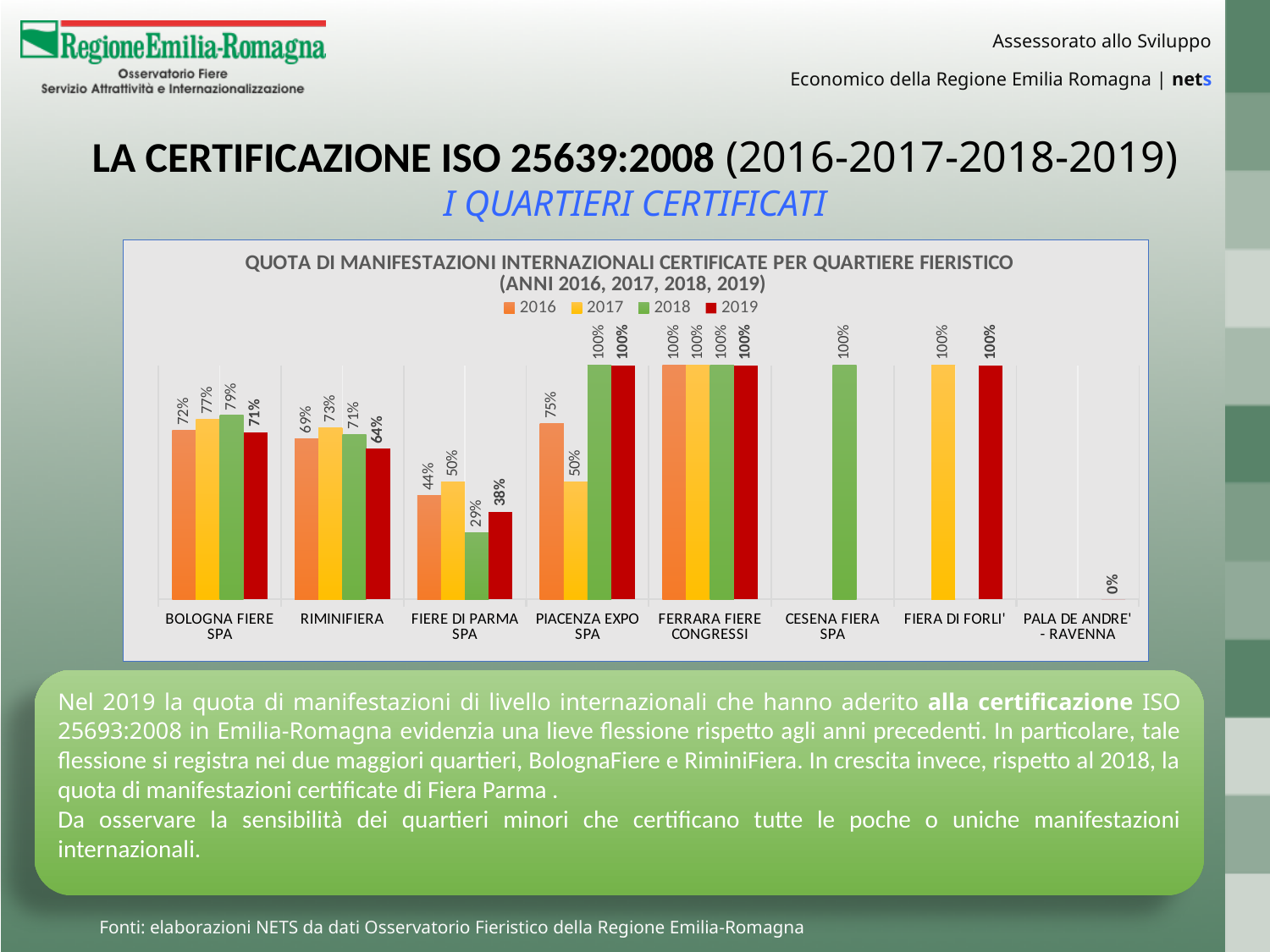
What is the 2017 value for RIMINIFIERA? 73% What is the 2016 value for PIACENZA EXPO SPA? 75% What is the difference between the 2018 and 2019 values for RIMINIFIERA? 7% Which year has the lowest value for FIERE DI PARMA SPA? 2018 How many fair districts (categories) are shown on the x axis? 8 What is the 2019 value for BOLOGNA FIERE SPA? 71% What kind of chart is shown on the slide? Bar chart What is the 2018 value for FIERE DI PARMA SPA? 29% How many series does the legend list? 4 Which year has the highest value for BOLOGNA FIERE SPA? 2018 Which is larger, the 2016 value for BOLOGNA FIERE SPA or the 2016 value for RIMINIFIERA? BOLOGNA FIERE SPA What is the value shown for PALA DE ANDRE' - RAVENNA? 0%